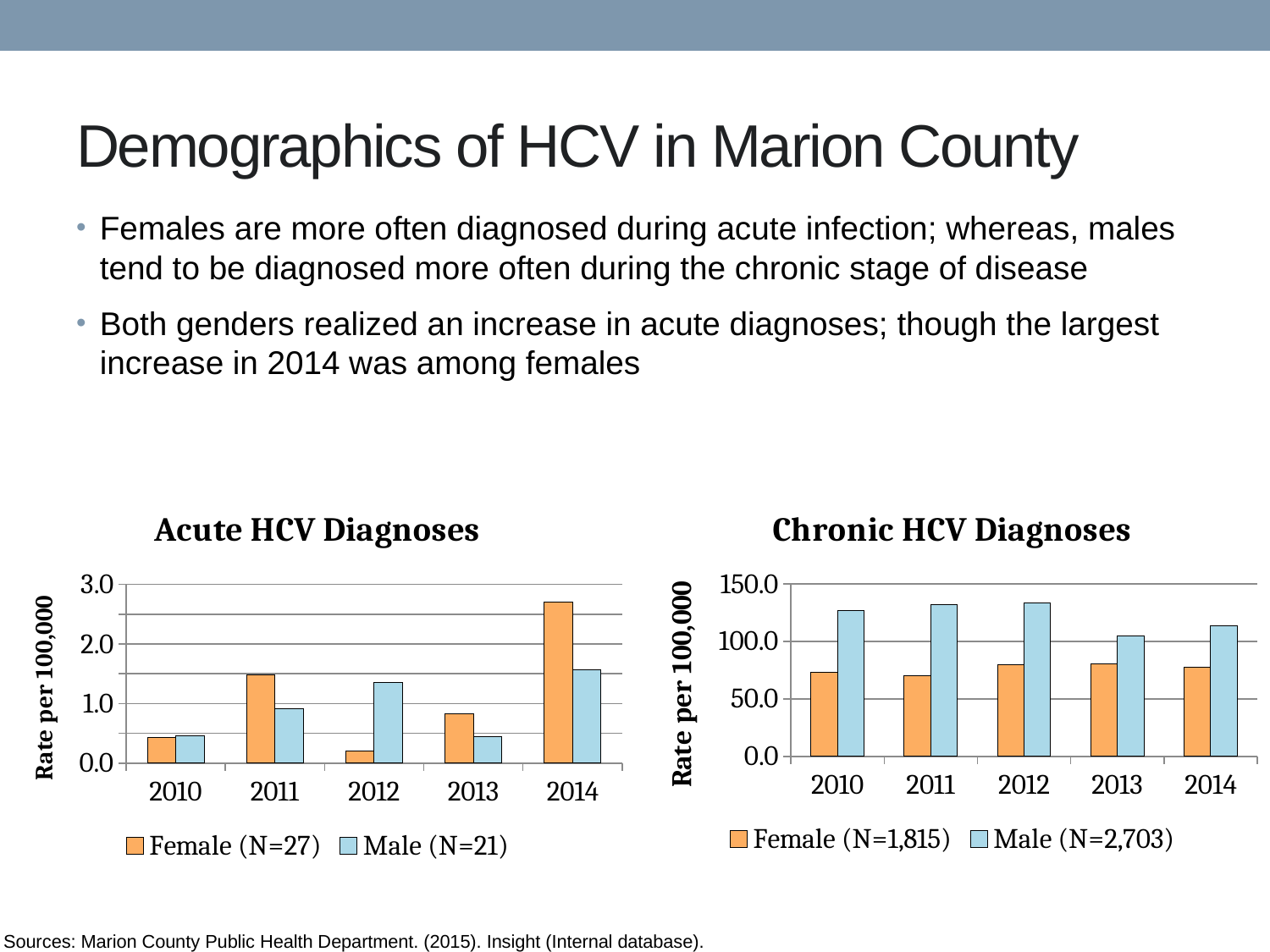
In the Chronic HCV Diagnoses chart, which is larger in 2010, the Female or the Male rate? Male In the Acute HCV Diagnoses chart, which year has the highest Female rate? 2014 In the Acute HCV Diagnoses chart, is the Male value for 2012 greater or less than 1.0? greater In the Acute HCV Diagnoses chart, is the Female value for 2014 greater or less than 2.0? greater What is the y-axis label of the Chronic HCV Diagnoses chart? Rate per 100,000 In the Acute HCV Diagnoses chart, which year has the lowest Female rate? 2012 How many series does the legend of the Chronic HCV Diagnoses chart list? 2 In the Chronic HCV Diagnoses chart, which year has the lowest Male rate? 2013 In the Chronic HCV Diagnoses chart, is the Male value for 2012 greater or less than 100.0? greater What kind of chart is the Acute HCV Diagnoses chart? bar chart In the Acute HCV Diagnoses chart, which is larger in 2011, the Female or the Male rate? Female How many years are shown on the x axis of the Acute HCV Diagnoses chart? 5